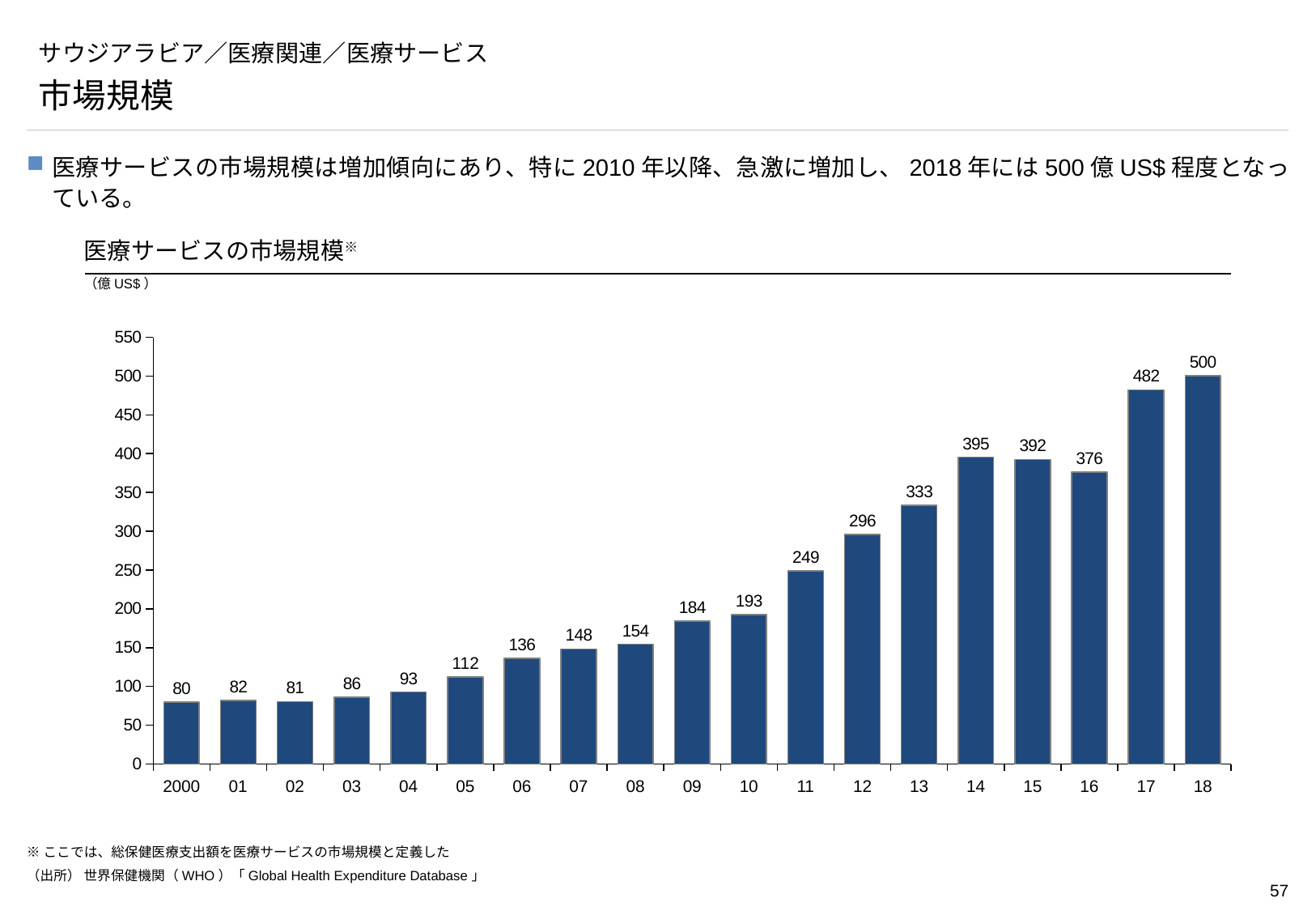
Which is larger, the value for 2015 or the value for 2016? 2015 What is the difference between the values for 2018 and 2017? 18 What is the value shown for 2000? 80 What unit is shown for the chart's values? 億 US$ How many years are plotted on the chart? 19 Do the values generally rise or fall from 2000 to 2018? rise Which year has the highest value? 18 What kind of chart is shown? bar chart What is the value shown for 2010? 193 What is the market size value shown for 2018? 500 What is the difference between the values for 2014 and 2013? 62 Which year has the lowest value? 2000